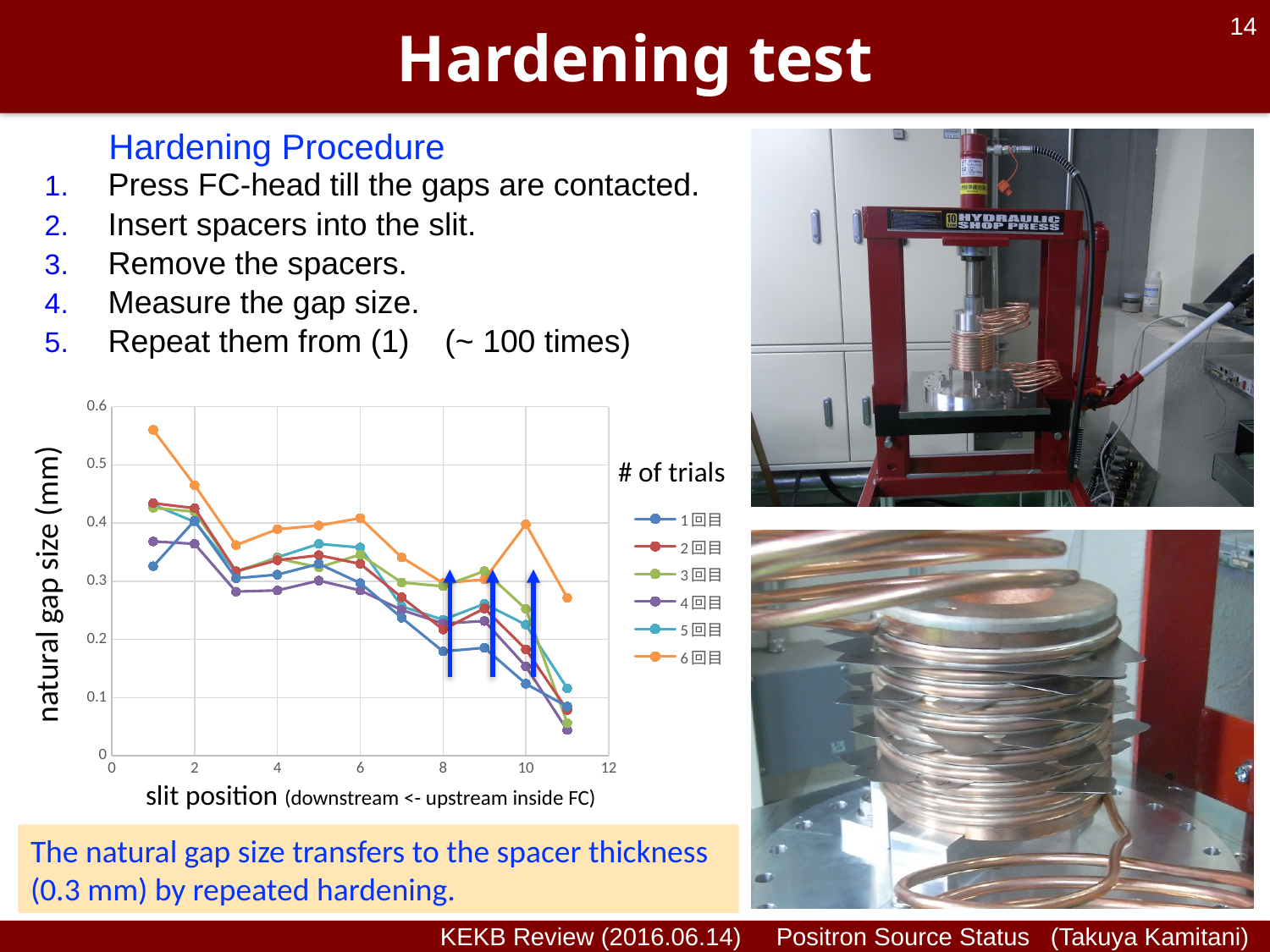
Which series has the lowest natural gap size at slit position 1? 1回目 How many series does the chart's legend list? 6 How many slit positions are plotted for the 6回目 series? 11 What is the label of the chart's y axis? natural gap size (mm) Is the value for 6回目 at slit position 10 greater or less than 0.3? greater Is the value for 6回目 at slit position 1 greater or less than 0.5? greater What is the title shown above the chart's legend? # of trials At slit position 10, which series has the larger value, 6回目 or 1回目? 6回目 Do the natural gap size values generally rise or fall as the slit position increases? fall Which series has the highest natural gap size at slit position 1? 6回目 What kind of chart is shown on the slide? line chart Is the value for 4回目 at slit position 11 greater or less than 0.1? less